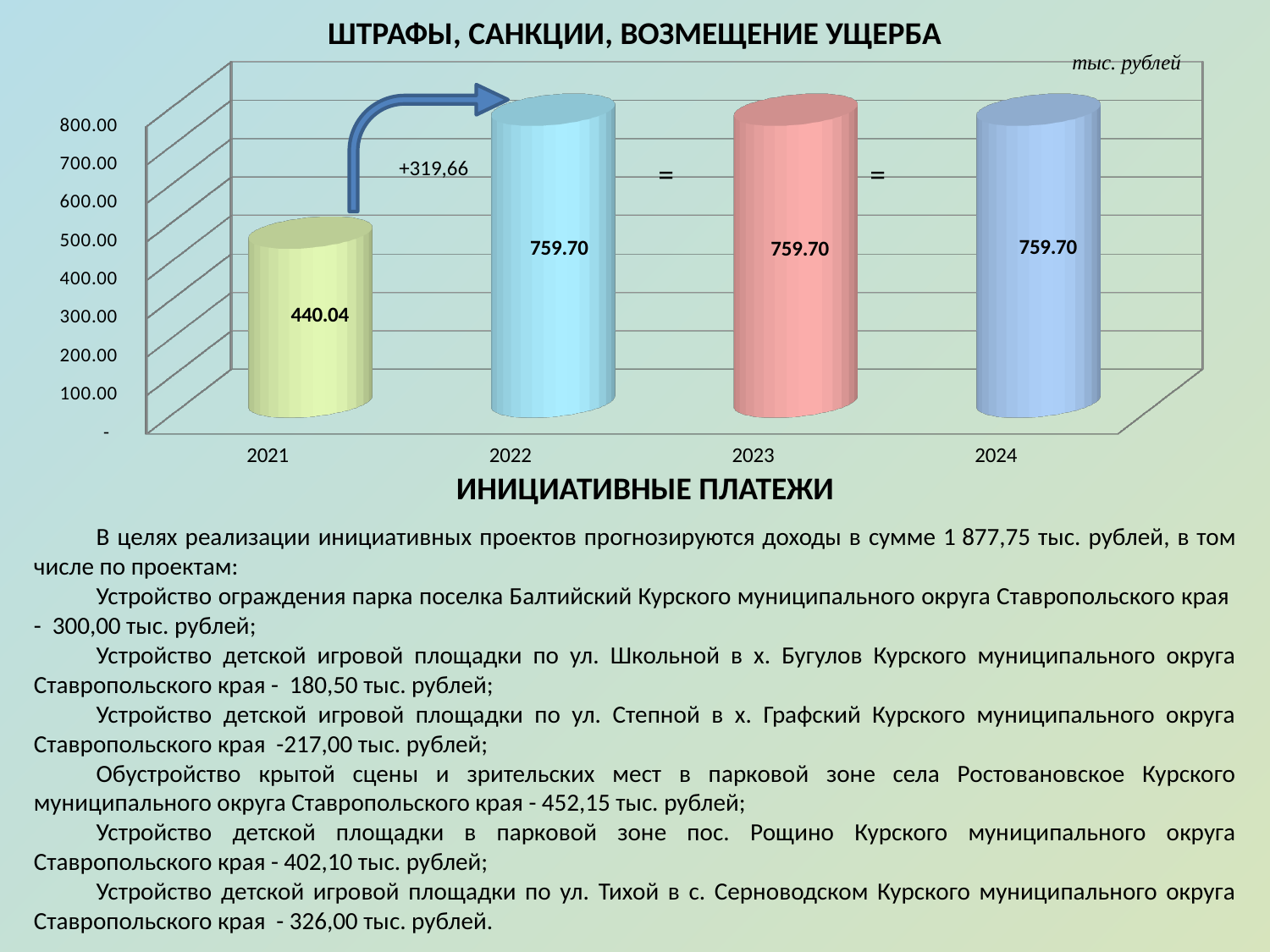
What is the highest value shown in the chart? 759.70 What unit of measurement is indicated for the chart? тыс. рублей Which is larger, the value for 2021 or the value for 2023? 2023 What kind of chart is shown on the slide? bar chart What is the value for 2021 in the chart? 440.04 What is the value for 2022 in the chart? 759.70 What is the difference between the values for 2022 and 2021? 319.66 Does the value rise or fall from 2021 to 2022? rise How many years are shown on the x axis of the chart? 4 What is the value for 2024 in the chart? 759.70 Is the value for 2021 greater or less than 500.00? less Which year has the lowest value in the chart? 2021